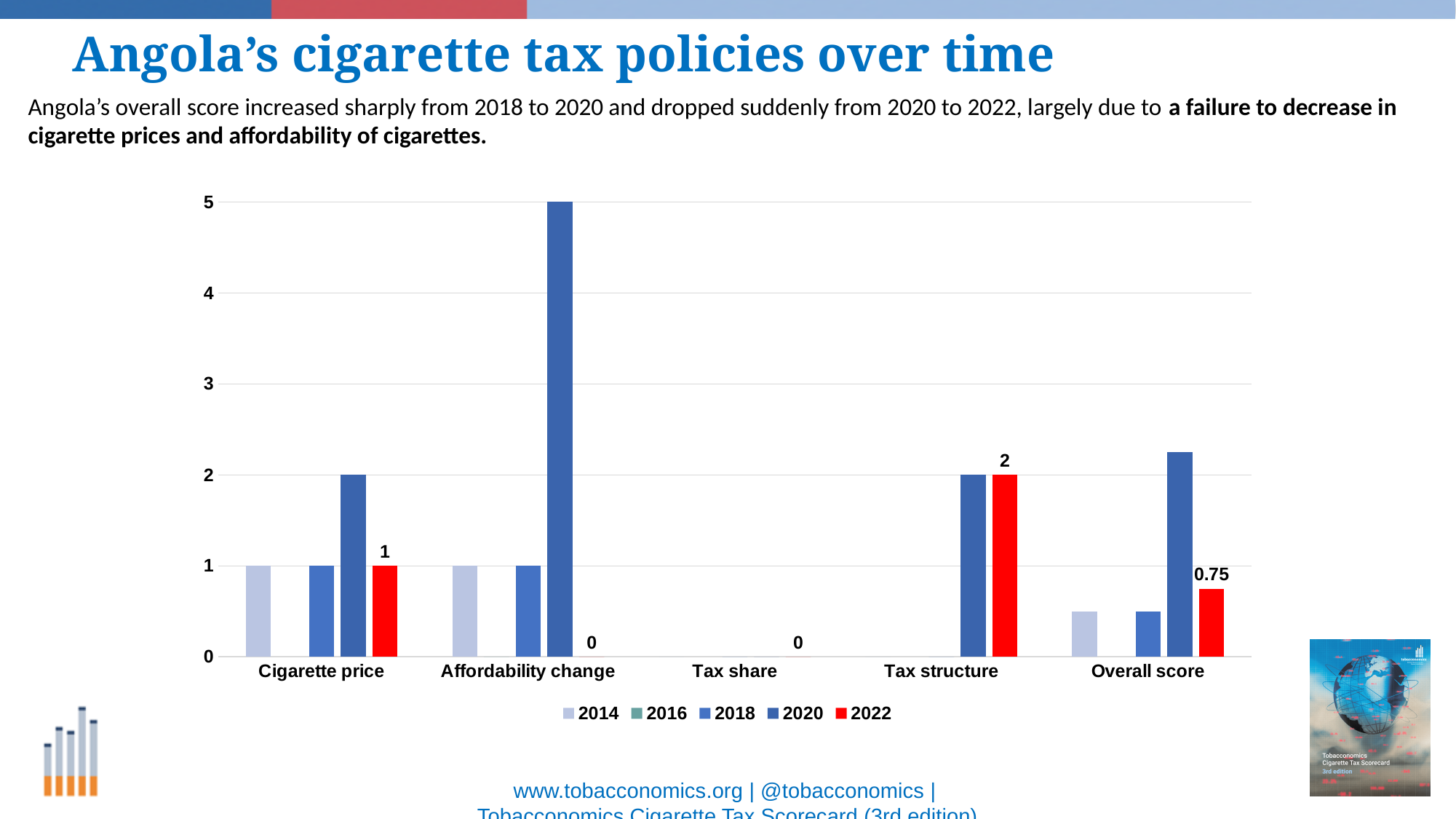
What is the 2022 value for Cigarette price? 1 How many series does the legend list? 5 What is the 2022 value for Overall score? 0.75 What is the 2022 value for Tax structure? 2 What kind of chart is shown on the slide? Bar chart Is the 2020 value for Overall score greater or less than 2? greater Which category has the highest 2020 value? Affordability change What colour represents the 2022 series in the legend? Red What is the difference between the 2020 and 2022 values for Affordability change? 5 Which is larger in 2022: Tax structure or Overall score? Tax structure How many categories are shown on the x axis? 5 What is the 2020 value for Affordability change? 5